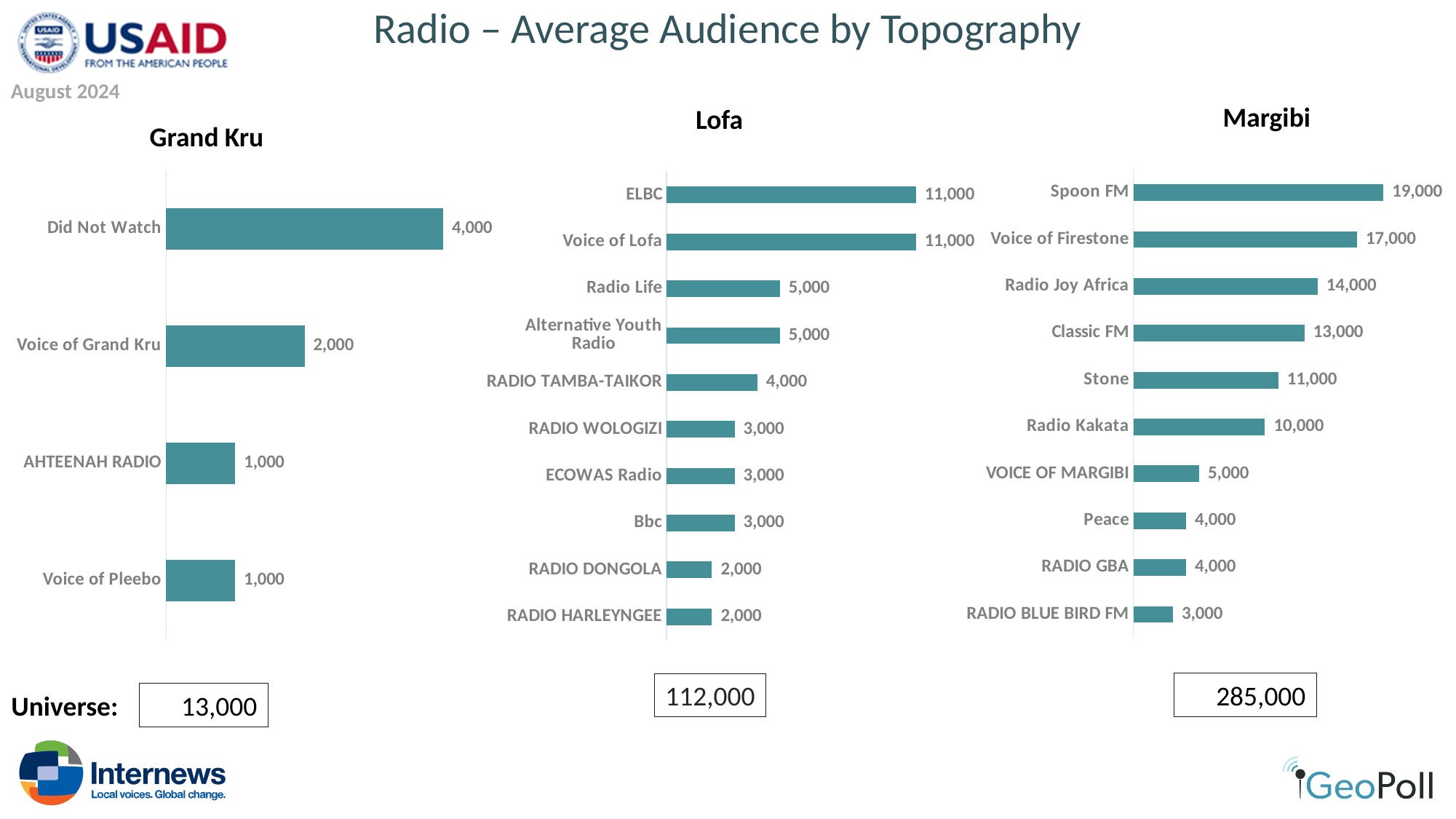
In the Lofa chart, how many categories are shown? 10 In the Grand Kru chart, how many categories are shown? 4 In the Margibi chart, which category has the highest value? Spoon FM What kind of chart is the Margibi chart? Bar chart In the Lofa chart, which category has the lowest value, RADIO DONGOLA or RADIO WOLOGIZI? RADIO DONGOLA In the Lofa chart, what is the value for RADIO TAMBA-TAIKOR? 4,000 In the Lofa chart, what is the difference between ELBC and Radio Life? 6,000 In the Grand Kru chart, which category has the highest value? Did Not Watch In the Margibi chart, which category has the lowest value? RADIO BLUE BIRD FM In the Margibi chart, what is the difference between Voice of Firestone and Classic FM? 4,000 In the Grand Kru chart, what is the value for Voice of Grand Kru? 2,000 In the Margibi chart, what is the value for Radio Kakata? 10,000